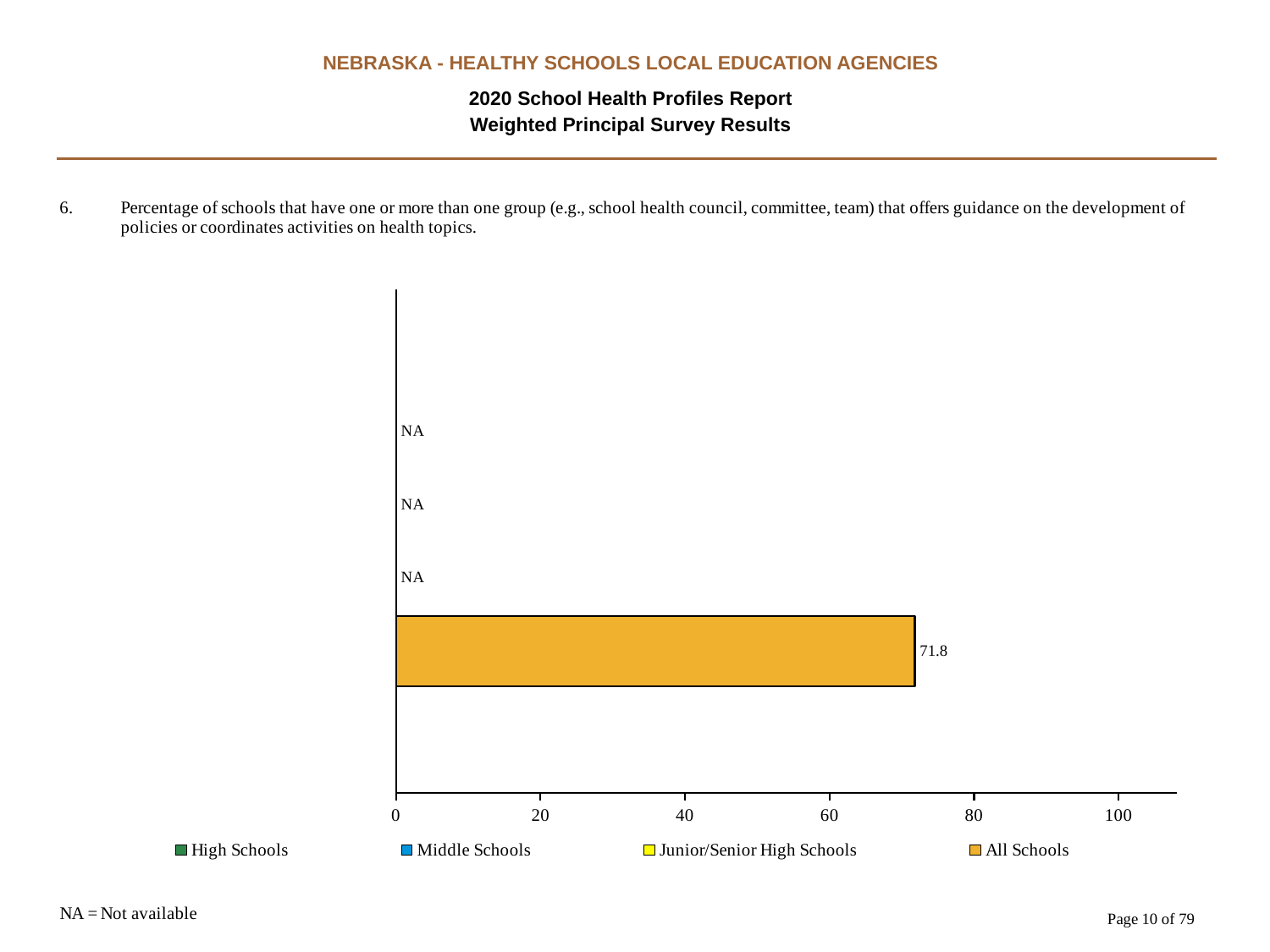
Which series does the legend list first? High Schools How many series does the legend list? 4 According to the note on the slide, what does NA stand for? Not available Is the value for All Schools greater or less than 80? less How many categories have a numeric value plotted as a bar? 1 What value is shown for High Schools? NA Is the value for All Schools greater or less than 60? greater What is the value shown for All Schools? 71.8 What value is shown for Middle Schools? NA What value is shown for Junior/Senior High Schools? NA What kind of chart is shown on the slide? bar chart